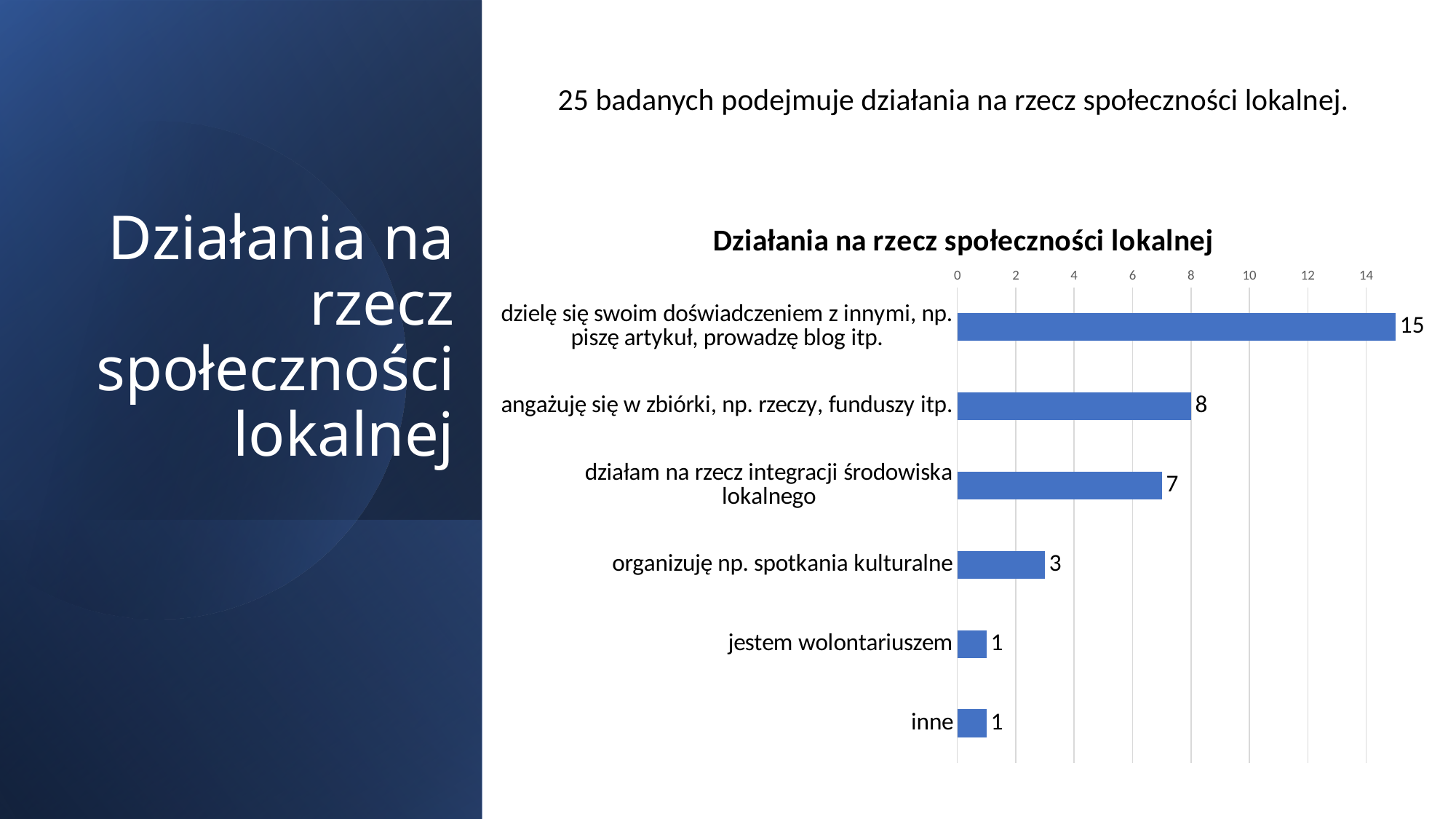
What is the title of the chart? Działania na rzecz społeczności lokalnej Is the value for "dzielę się swoim doświadczeniem z innymi, np. piszę artykuł, prowadzę blog itp." greater or less than 10? greater What kind of chart is shown on the slide? bar chart What is the value for "jestem wolontariuszem"? 1 How many categories are shown in the chart? 6 What is the value for "działam na rzecz integracji środowiska lokalnego"? 7 Which category has the highest value? dzielę się swoim doświadczeniem z innymi, np. piszę artykuł, prowadzę blog itp. Which is larger: the value for "działam na rzecz integracji środowiska lokalnego" or the value for "organizuję np. spotkania kulturalne"? działam na rzecz integracji środowiska lokalnego What is the value for "organizuję np. spotkania kulturalne"? 3 What is the value for "angażuję się w zbiórki, np. rzeczy, funduszy itp."? 8 What is the difference between the values for "dzielę się swoim doświadczeniem z innymi, np. piszę artykuł, prowadzę blog itp." and "angażuję się w zbiórki, np. rzeczy, funduszy itp."? 7 What is the difference between the values for "organizuję np. spotkania kulturalne" and "inne"? 2